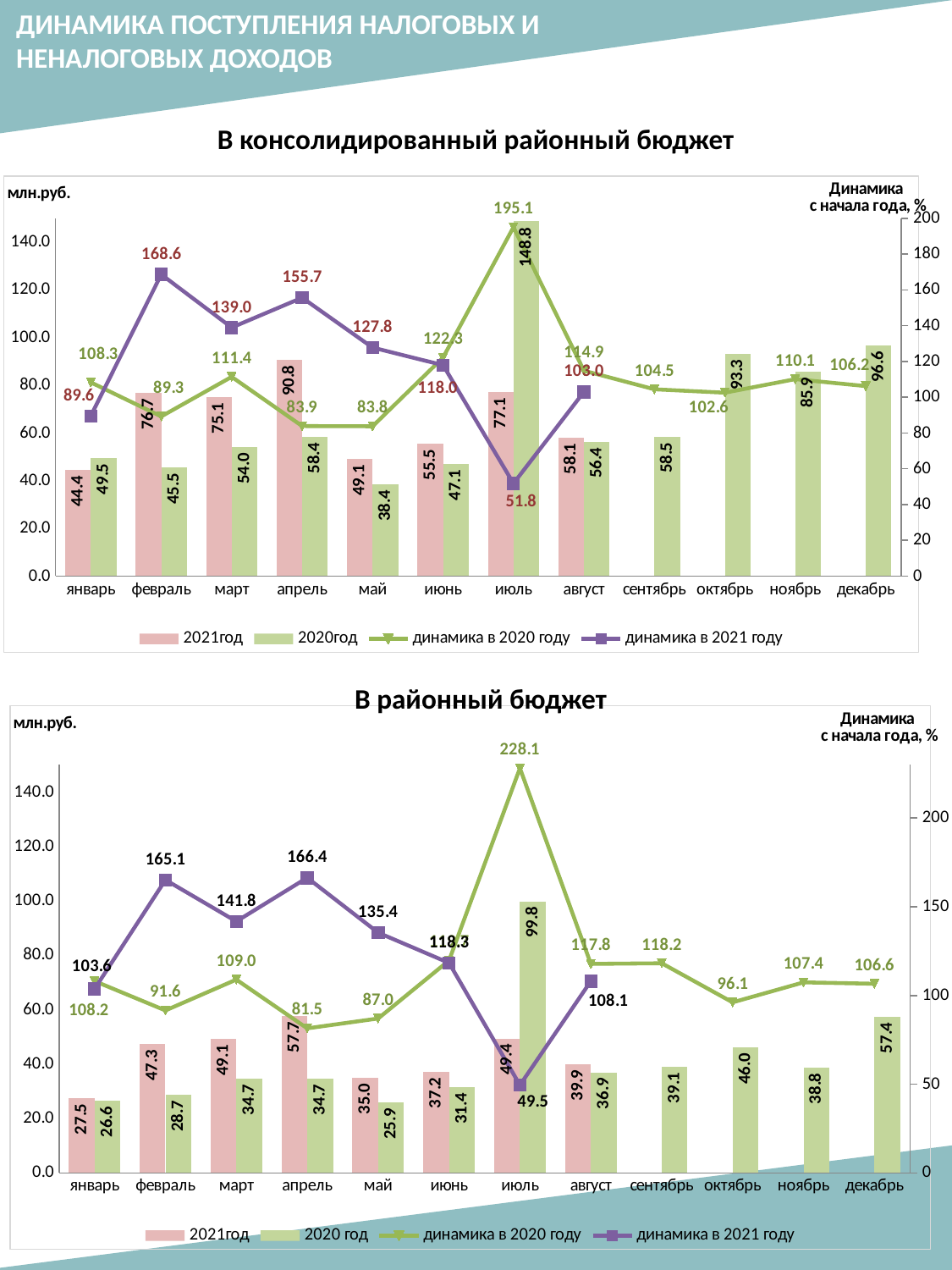
In the chart 'В консолидированный районный бюджет', what is the difference between the 2021год and 2020год bars for февраль? 31.2 In the chart 'В консолидированный районный бюджет', which month has the highest value on the 'динамика в 2021 году' line? февраль In the chart 'В консолидированный районный бюджет', which month has the lowest 2020год bar? май In the chart 'В районный бюджет', which is larger for март: the 2021год bar or the 2020год bar? 2021год In the chart 'В районный бюджет', what is the value of the 2021год bar for январь? 27.5 In the chart 'В консолидированный районный бюджет', what is the value of the 2021год bar for апрель? 90.8 In the chart 'В районный бюджет', what unit is shown on the left vertical axis label? млн.руб. In the chart 'В консолидированный районный бюджет', how many series does the legend list? 4 In the chart 'В консолидированный районный бюджет', what is the value of the 2020год bar for июль? 148.8 In the chart 'В районный бюджет', which month has the lowest value on the 'динамика в 2021 году' line? июль In the chart 'В районный бюджет', how many months are shown on the x axis? 12 In the chart 'В районный бюджет', what is the value of the 'динамика в 2020 году' line for июль? 228.1